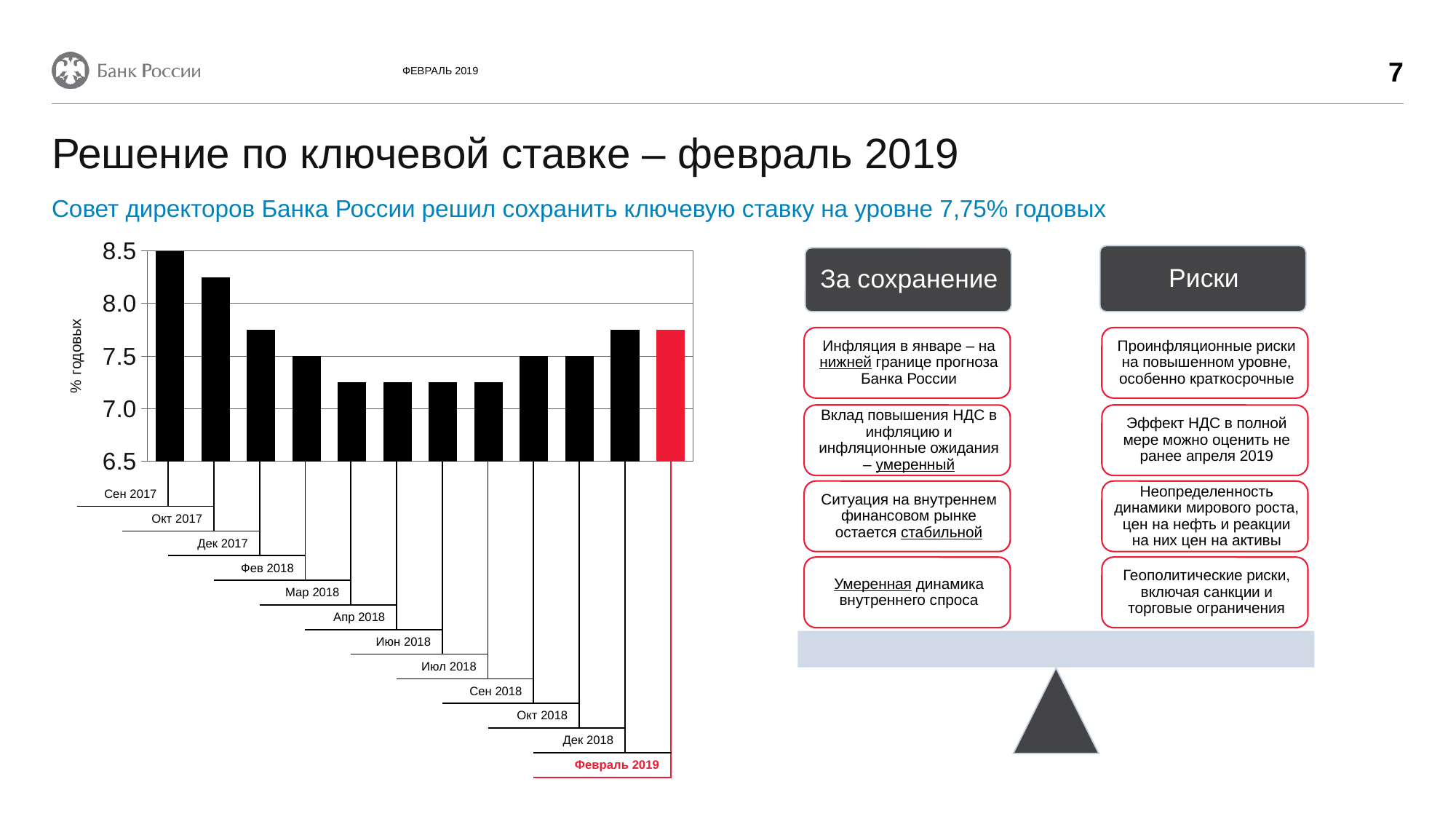
What is the value for Окт 2018 in the chart? 7.5 What kind of chart is shown on the slide? bar chart Is the value for Мар 2018 greater or less than 7.5? less What is the value for Сен 2017 in the chart? 8.5 Which is larger, the value for Сен 2017 or the value for Окт 2017? Сен 2017 Is the value for Окт 2017 greater or less than 8.0? greater Which month has the highest key rate in the chart? Сен 2017 How many bars (months) are plotted in the chart? 12 Do the values rise or fall from Сен 2017 to Мар 2018? fall What is the value for Фев 2018 in the chart? 7.5 What is the label of the vertical axis of the chart? % годовых Is the value for Дек 2018 greater or less than 8.0? less